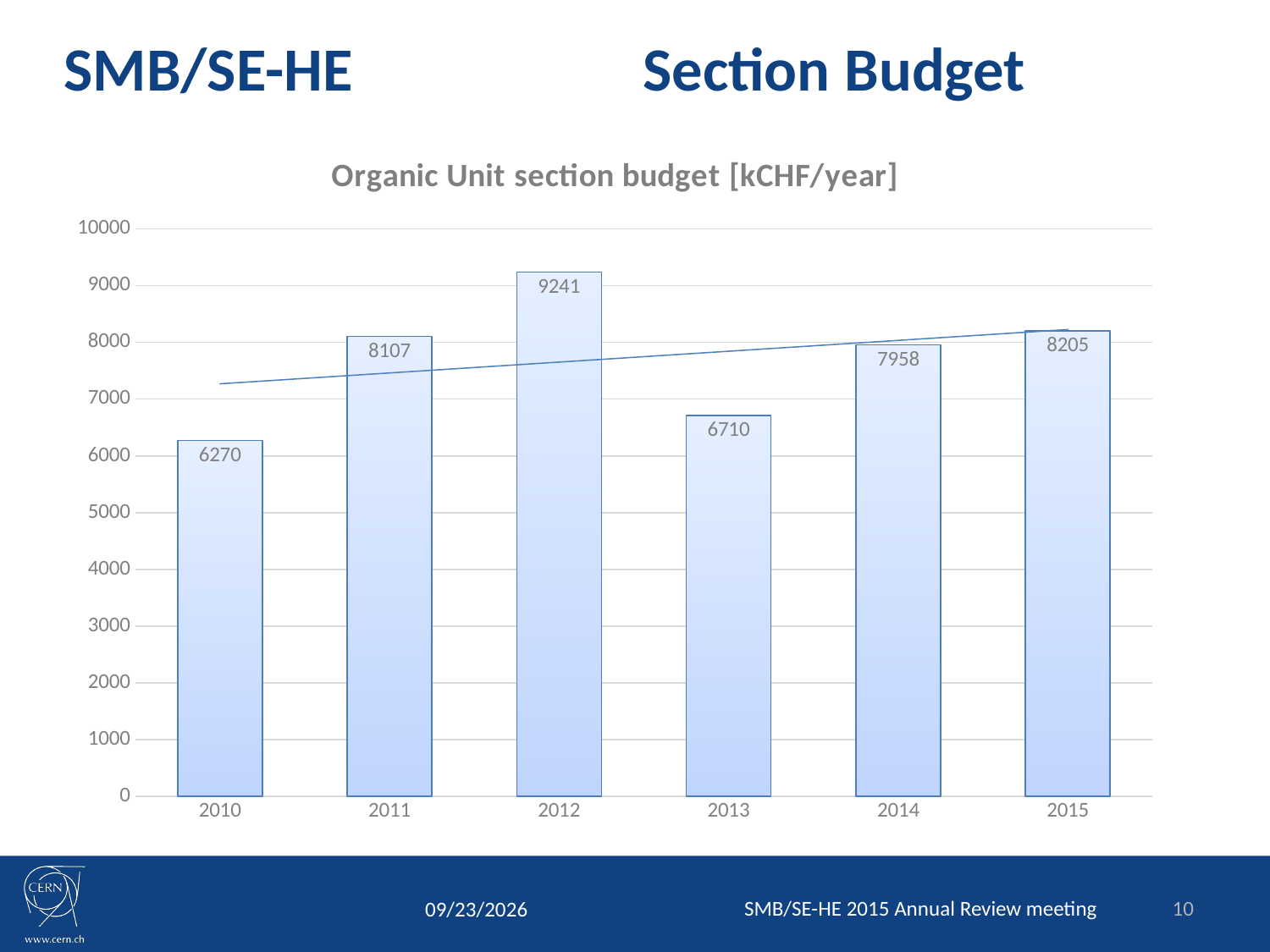
Is the value for 2013 greater or less than 7000? less Which year has a larger budget, 2011 or 2013? 2011 How many years are shown on the x axis? 6 What is the section budget value for 2012? 9241 What is the title of the chart? Organic Unit section budget [kCHF/year] Which year has the lowest section budget? 2010 What kind of chart is shown on the slide? bar chart What is the difference between the 2015 and 2010 budget values? 1935 What is the difference between the 2012 and 2013 budget values? 2531 Which year has the highest section budget? 2012 What is the section budget value for 2010? 6270 What is the section budget value for 2014? 7958